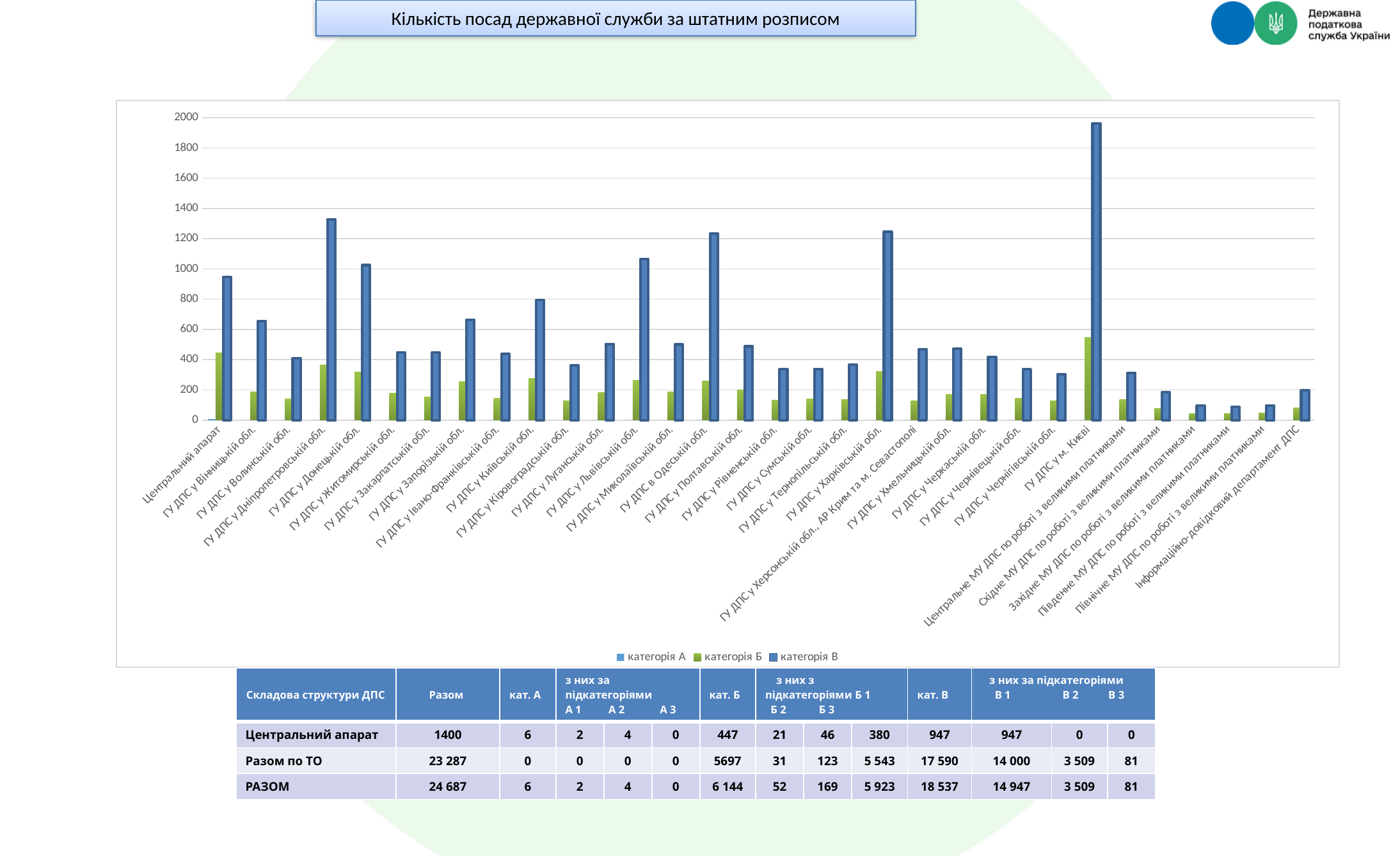
Is the категорія В value for ГУ ДПС у Волинській обл. greater or less than 600? less What are the three series named in the chart legend? категорія А, категорія Б, категорія В Which category has the highest категорія Б bar? ГУ ДПС у м. Києві What kind of chart is shown on the slide? bar chart Which category has the highest категорія В bar? ГУ ДПС у м. Києві How many categories are shown along the x axis of the chart? 32 What is the title of the slide's chart? Кількість посад державної служби за штатним розписом Is the категорія В value for ГУ ДПС у Харківській обл. greater or less than 1000? greater Which has the larger категорія В bar: ГУ ДПС у Дніпропетровській обл. or ГУ ДПС у Донецькій обл.? ГУ ДПС у Дніпропетровській обл. Is the категорія В value for ГУ ДПС у Дніпропетровській обл. greater or less than 1200? greater Which has the larger категорія В bar: ГУ ДПС у Київській обл. or ГУ ДПС у Запорізькій обл.? ГУ ДПС у Київській обл. How many series does the chart legend list? 3